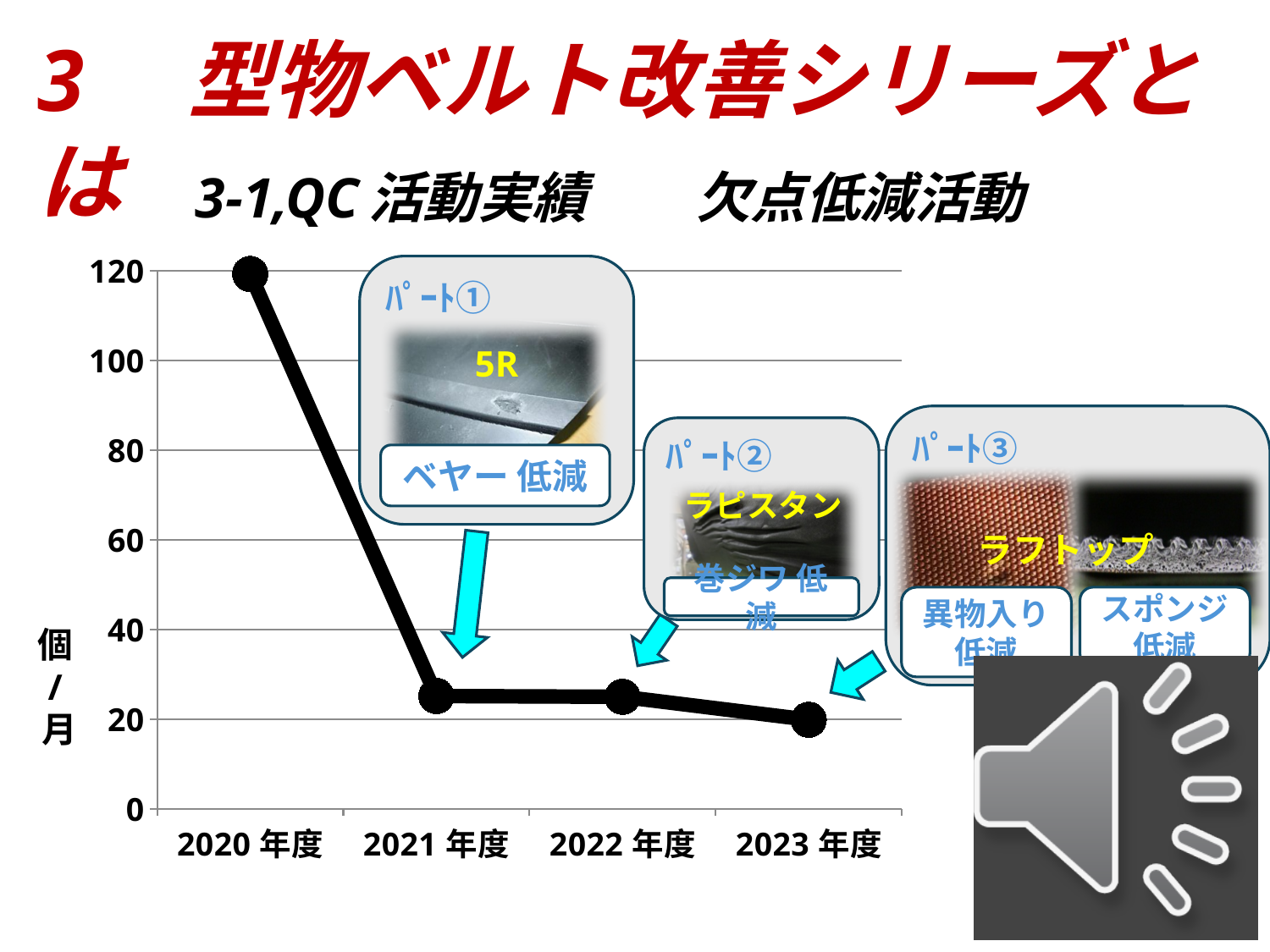
What kind of chart is shown on the slide? line chart Is the value for 2022年度 greater or less than 20? greater What is the label on the vertical axis of the chart? 個/月 Do the values rise or fall from 2020年度 to 2023年度? fall Which is larger, the value for 2020年度 or the value for 2021年度? 2020年度 Which year has the highest value on the line chart? 2020年度 Is the value for 2021年度 greater or less than 40? less How many data points are plotted on the line chart? 4 Which year has the lowest value on the line chart? 2023年度